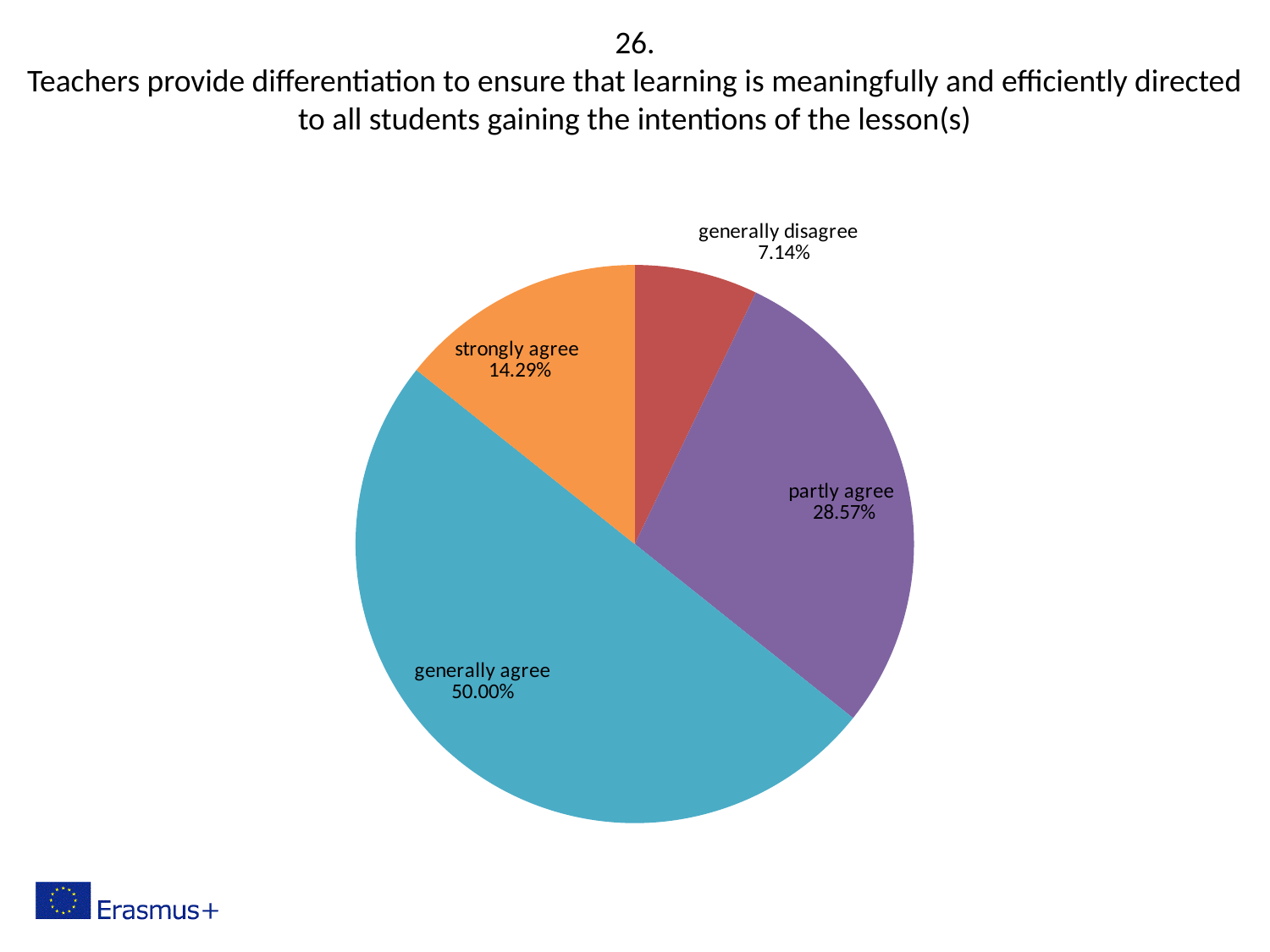
Which is larger, the share for "partly agree" or the share for "strongly agree"? partly agree Which category has the smallest slice of the pie? generally disagree How many slices does the pie chart have? 4 What percentage is shown for "partly agree"? 28.57% What colour is the "generally agree" slice? teal blue What share of the pie is labelled "generally agree"? 50.00% What is the difference in percentage points between "strongly agree" and "generally disagree"? 7.15 What percentage is shown for "generally disagree"? 7.14% Which category has the largest slice of the pie? generally agree What kind of chart is shown on the slide? pie chart What percentage is shown for "strongly agree"? 14.29% What is the difference in percentage points between "generally agree" and "partly agree"? 21.43